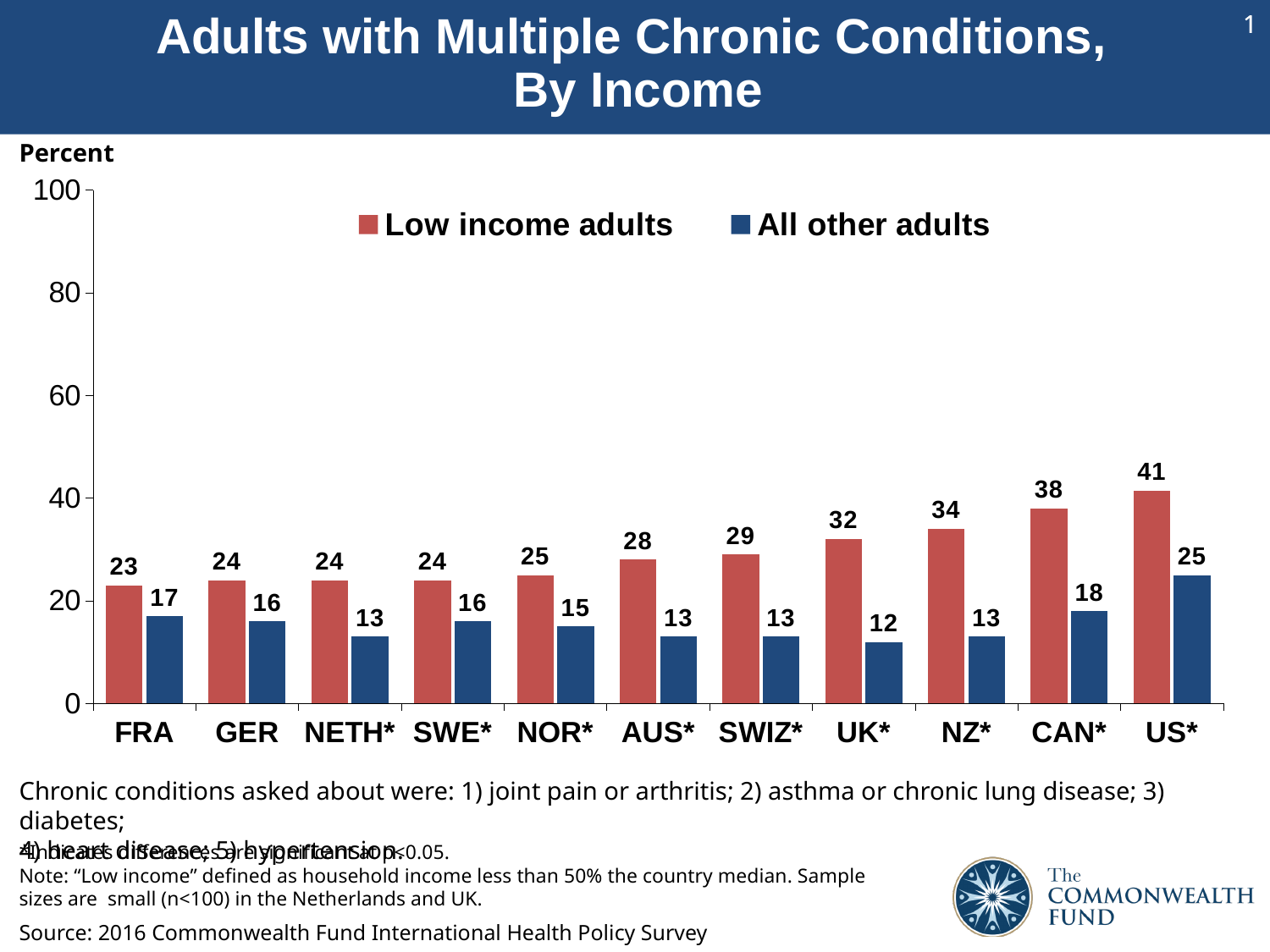
How many countries are shown on the x axis? 11 Which country has the highest value for Low income adults? US* What kind of chart is shown on the slide? Bar chart What is the difference between Low income adults and All other adults in CAN*? 20 Which country has the lowest value for All other adults? UK* Which is larger: the Low income adults value for NZ* or the Low income adults value for SWIZ*? NZ* Is the value for Low income adults in UK* greater or less than 20? greater What is the value for All other adults in GER? 16 How many series does the legend list? 2 What is the value for Low income adults in US*? 41 Do the Low income adults values rise or fall from FRA to US* along the x axis? Rise What colour are the bars for All other adults? Blue